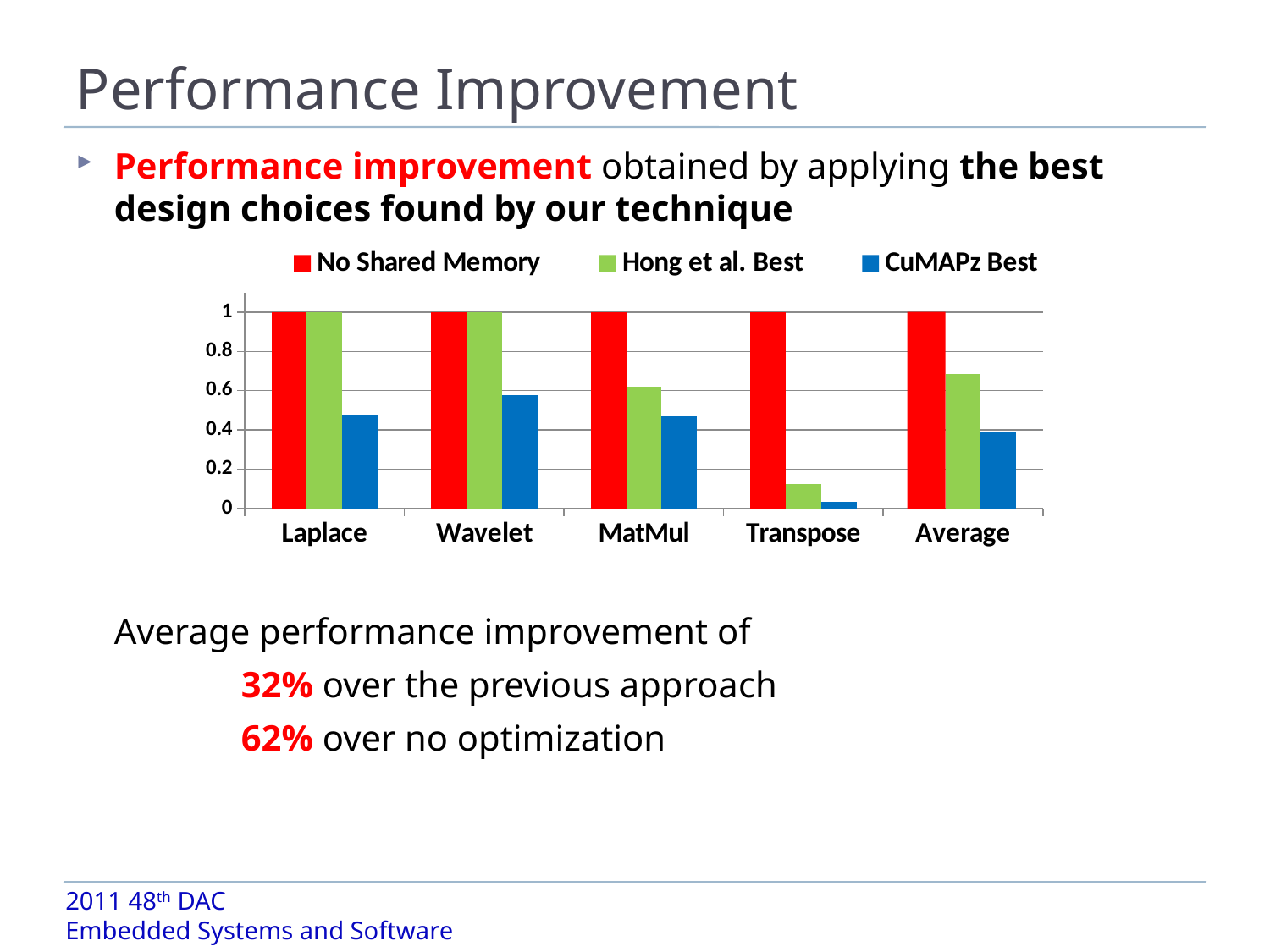
For MatMul, which is larger: Hong et al. Best or CuMAPz Best? Hong et al. Best What kind of chart is shown on the slide? bar chart What is the value of Hong et al. Best for Wavelet? 1 Which category has the lowest Hong et al. Best value? Transpose Is the Hong et al. Best value for Transpose greater or less than 0.2? less What is the value of No Shared Memory for MatMul? 1 Is the CuMAPz Best value for Wavelet greater or less than 0.4? greater How many series does the legend list? 3 How many categories are shown on the x axis? 5 Which category has the lowest CuMAPz Best value? Transpose Is the CuMAPz Best value for Average greater or less than 0.2? greater Which colour represents the CuMAPz Best series? blue